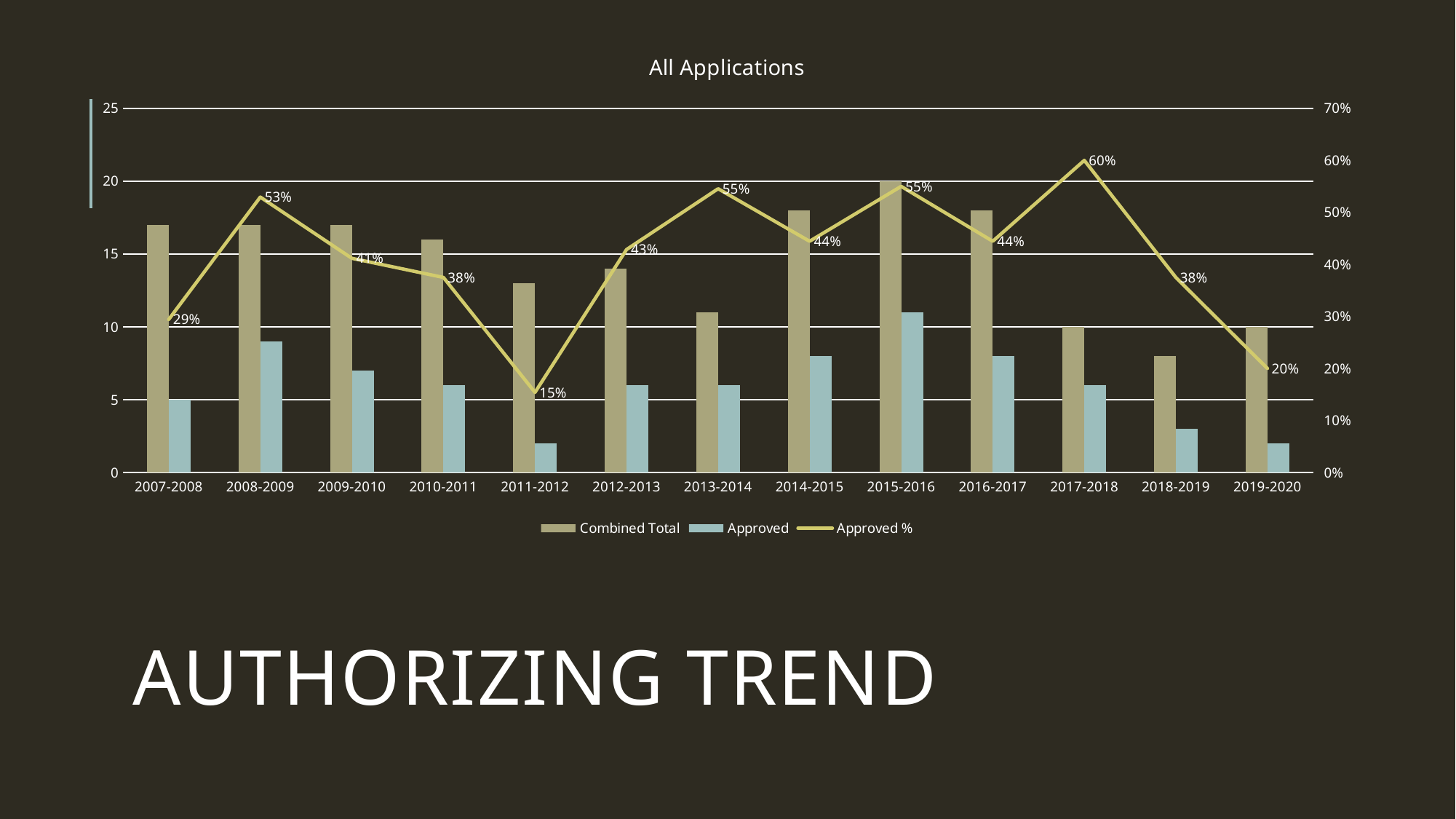
What is the Approved % for 2007-2008? 29% How many series does the legend list? 3 What is the Approved % for 2017-2018? 60% Which year has the lowest Approved %? 2011-2012 What is the Approved % for 2011-2012? 15% Is the Combined Total for 2011-2012 greater or less than 15? less What is the difference in Approved % between 2017-2018 and 2019-2020? 40% How many year categories are shown on the x axis? 13 Is the Approved value for 2015-2016 greater or less than 10? greater Which year has a higher Approved %, 2008-2009 or 2012-2013? 2008-2009 What is the title of the chart? All Applications Which year has the highest Approved %? 2017-2018